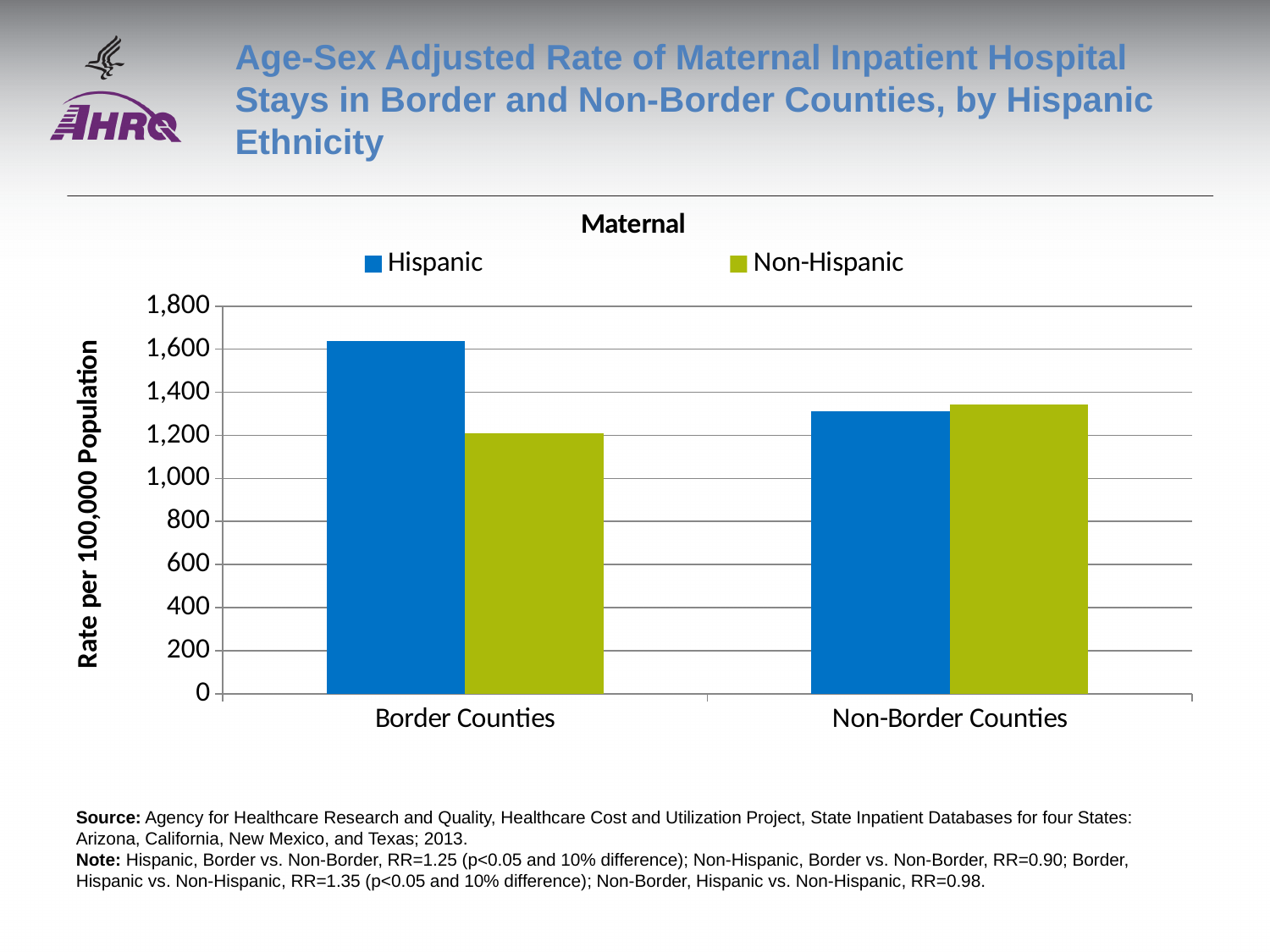
How many county categories are shown on the x axis? 2 In Border Counties, which is larger: the Hispanic rate or the Non-Hispanic rate? Hispanic For the Non-Hispanic series, which is larger: Border Counties or Non-Border Counties? Non-Border Counties For the Hispanic series, which is larger: Border Counties or Non-Border Counties? Border Counties Is the Non-Hispanic value for Border Counties greater or less than 1,400? less Is the Hispanic value for Non-Border Counties greater or less than 1,200? greater Is the Hispanic value for Border Counties greater or less than 1,600? greater What is the label of the y axis? Rate per 100,000 Population What kind of chart is shown on the slide? Bar chart Which bar is the lowest in the chart? Non-Hispanic, Border Counties How many series does the legend list? 2 Which series has the highest bar in the chart? Hispanic, Border Counties